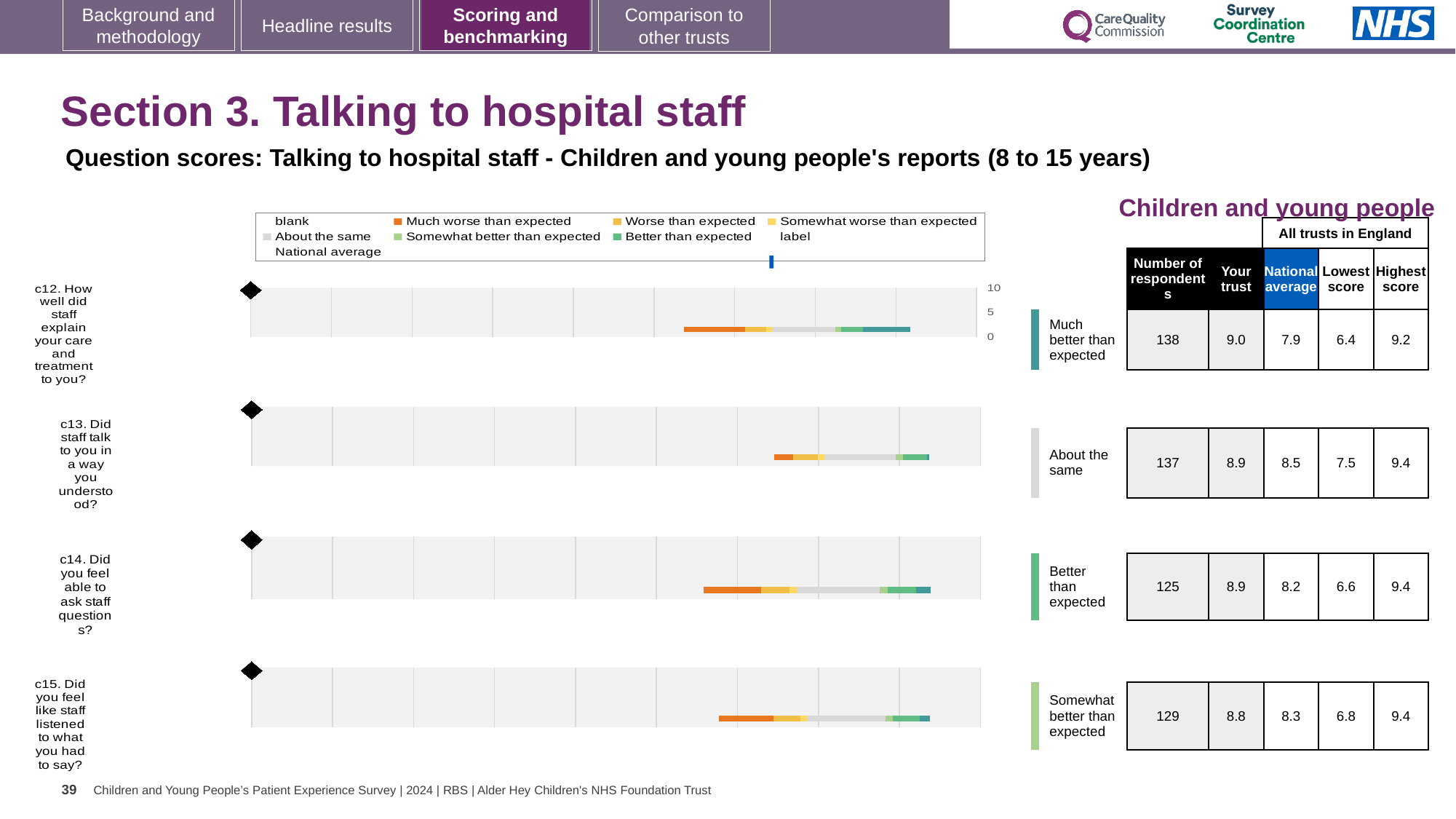
Which benchmark category is shown for c13 (Did staff talk to you in a way you understood?)? About the same How many respondents answered c14 (Did you feel able to ask staff questions?)? 125 Which benchmark category is shown for c12 (How well did staff explain your care and treatment to you?)? Much better than expected What is the highest score across all trusts in England for c15 (Did you feel like staff listened to what you had to say?)? 9.4 Which question has the lowest national average score? c12 What is the national average score for c13 (Did staff talk to you in a way you understood?)? 8.5 Which has the higher national average score, c13 or c14? c13 What is the difference between the 'Your trust' score and the national average for c12? 1.1 Which question has the highest 'Your trust' score? c12 How many survey questions (c12 to c15) have a chart on this slide? 4 What kind of chart is used to show the question scores for c12 to c15? bar chart What is the 'Your trust' score for c12 (How well did staff explain your care and treatment to you?)? 9.0